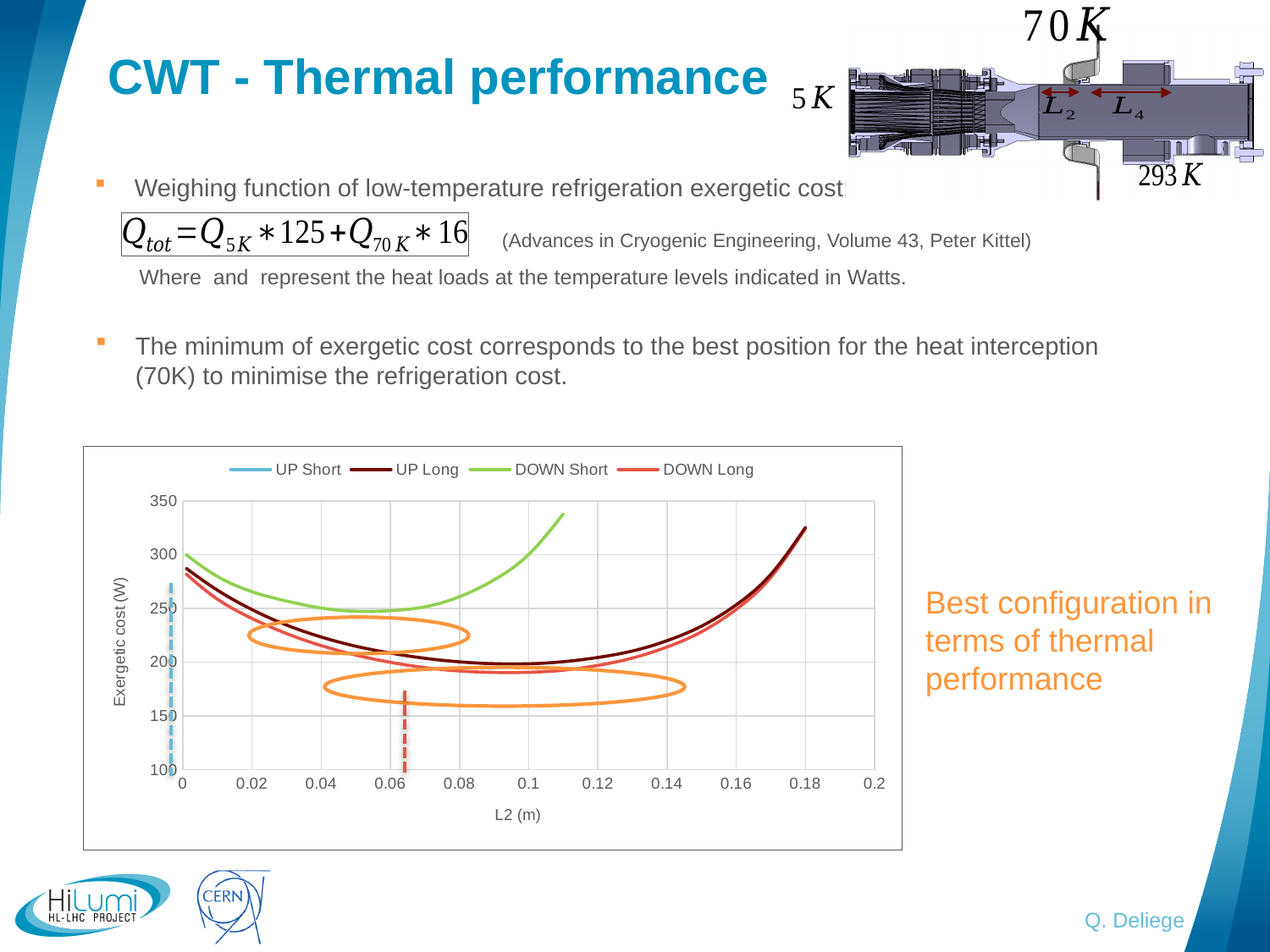
What are the series names listed in the chart legend? UP Short, UP Long, DOWN Short, DOWN Long What kind of chart is shown on the slide? line chart Is the lowest point of the DOWN Long curve greater or less than 250? less Is the UP Long value at L2 = 0.18 greater or less than 300? greater What is the title of the chart's x axis? L2 (m) How many series does the chart legend list? 4 Does the DOWN Short curve rise or fall as L2 increases from 0.06 to 0.1? rise Is the lowest point of the DOWN Short curve greater or less than 200? greater Does the UP Long curve rise or fall as L2 increases from 0 to 0.08? fall At L2 = 0.1, which series has the higher exergetic cost, DOWN Short or UP Long? DOWN Short